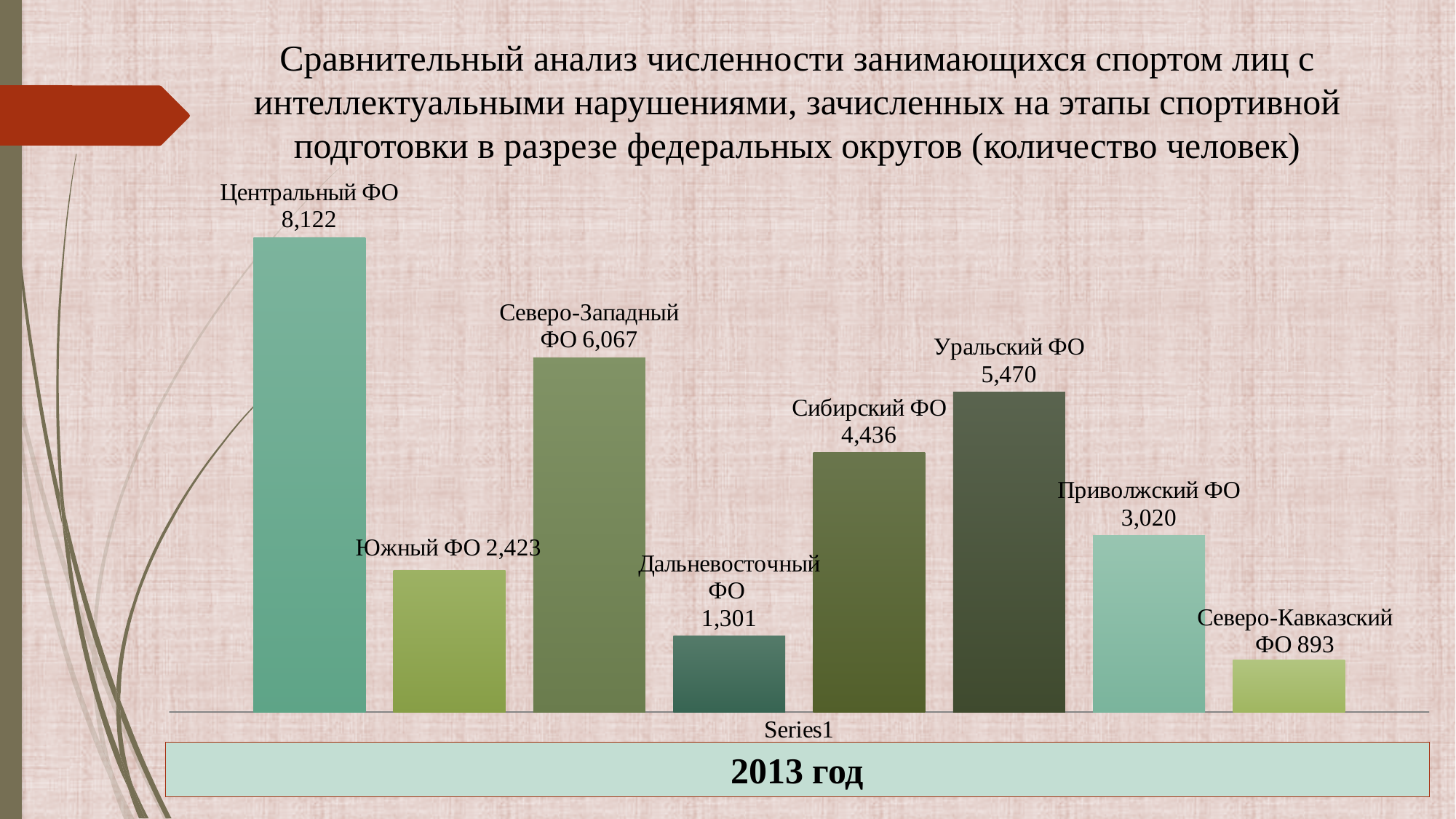
What kind of chart is shown on the slide? Bar chart Which federal district has the highest value? Центральный ФО Which is larger, the value for Южный ФО or the value for Приволжский ФО? Приволжский ФО What is the difference between the values for Северо-Западный ФО and Уральский ФО? 597 Which federal district has the lowest value? Северо-Кавказский ФО What is the value for Сибирский ФО? 4,436 What is the difference between the values for Центральный ФО and Северо-Кавказский ФО? 7,229 What is the value for Северо-Кавказский ФО? 893 What is the value for Дальневосточный ФО? 1,301 What year is indicated below the chart? 2013 год How many federal districts are shown in the chart? 8 What is the value for Центральный ФО? 8,122